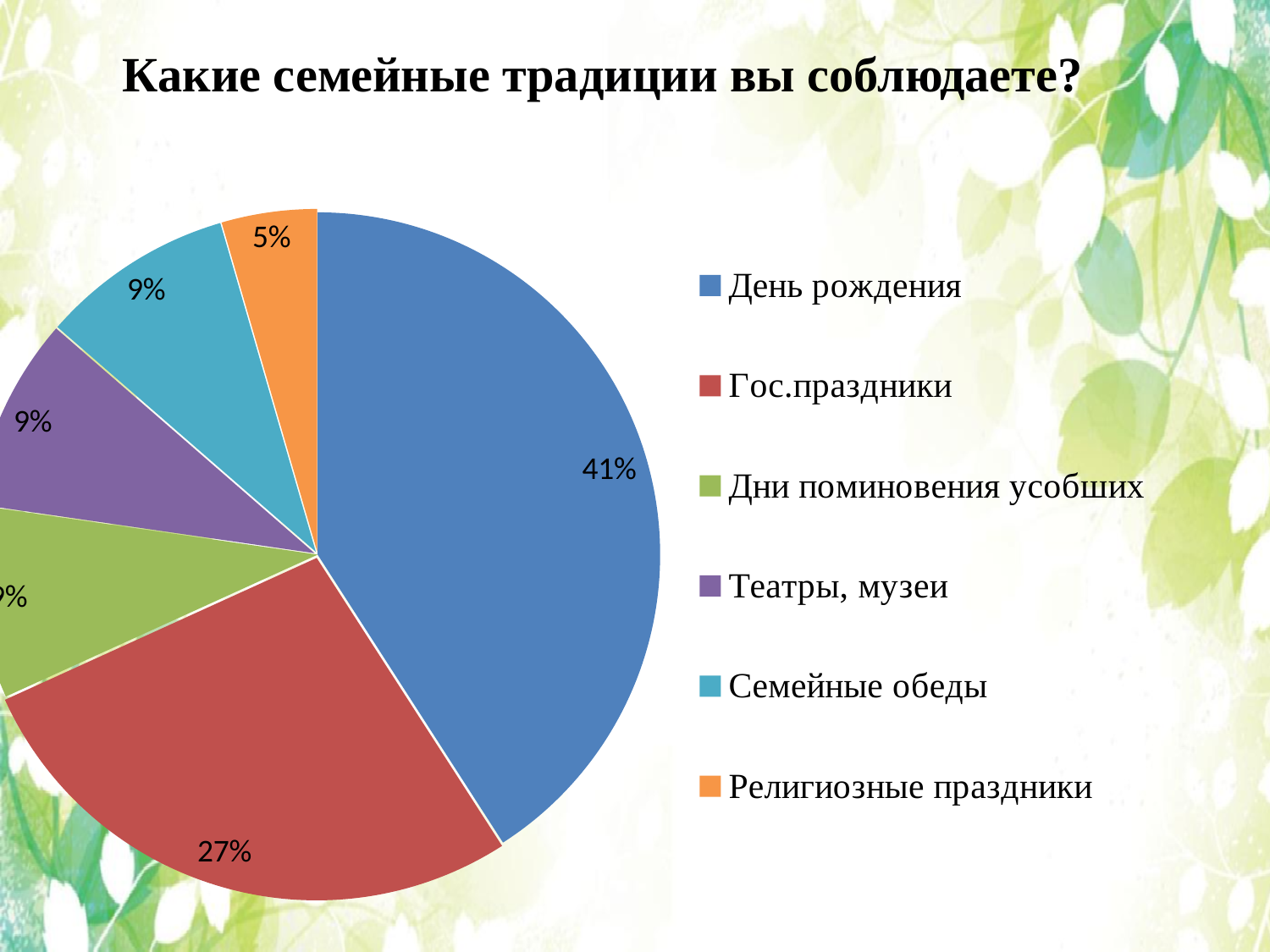
Which is larger, Гос.праздники or Семейные обеды? Гос.праздники Which category has the smallest slice of the pie? Религиозные праздники Which category has the largest slice of the pie? День рождения What percentage is shown for Гос.праздники? 27% What percentage is shown for Семейные обеды? 9% What percentage is shown for Религиозные праздники? 5% What share of the pie does День рождения have? 41% What percentage is shown for Театры, музеи? 9% How many categories does the legend list? 6 How many percentage points larger is День рождения than Гос.праздники? 14 What type of chart is shown on the slide? Pie chart What colour is the slice for Религиозные праздники? Orange